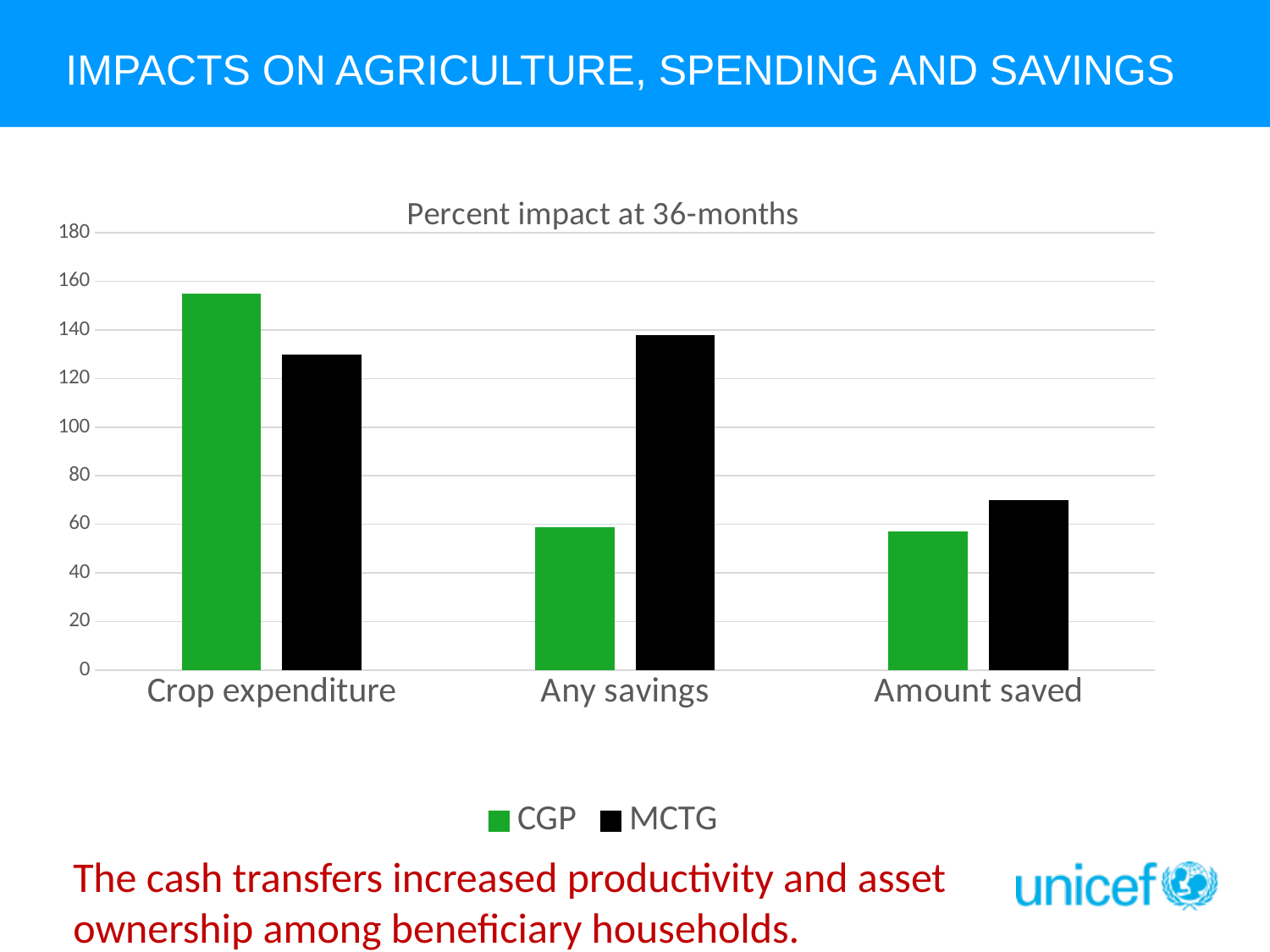
What kind of chart is shown on the slide? Bar chart For Any savings, which series has the larger value, CGP or MCTG? MCTG For Crop expenditure, which series has the larger value, CGP or MCTG? CGP Which category has the highest CGP value? Crop expenditure Is the MCTG value for Amount saved greater or less than 100? less How many categories are shown on the x axis? 3 Which colour represents the CGP series? Green What is the title of the chart? Percent impact at 36-months How many series does the legend list? 2 Is the CGP value for Crop expenditure greater or less than 140? greater Is the MCTG value for Any savings greater or less than 120? greater